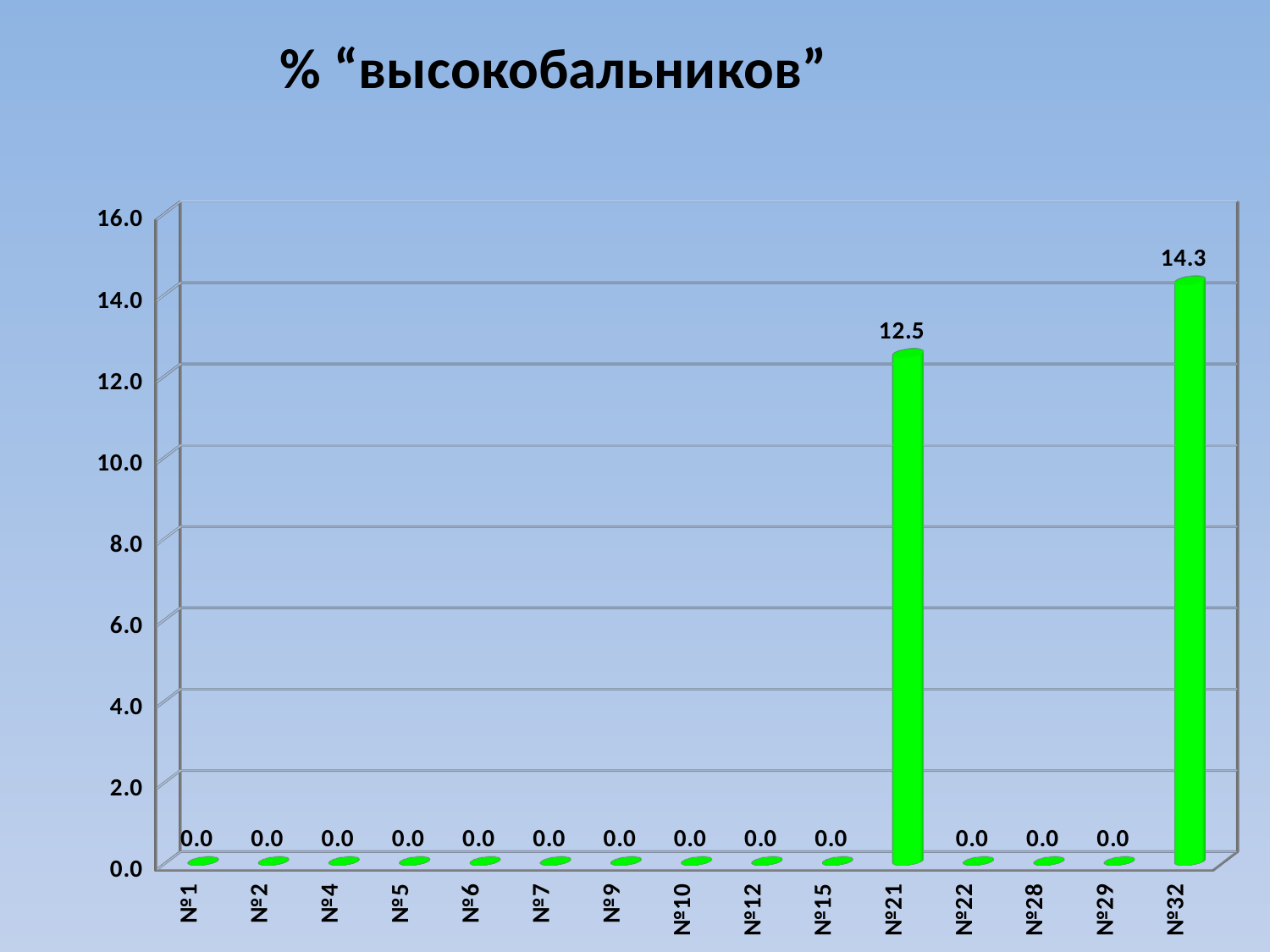
Is the value for №21 greater or less than 10.0? greater What kind of chart is shown on the slide? bar chart What is the value for №21? 12.5 What is the title of the chart? % “высокобальников” What is the difference between the values for №32 and №21? 1.8 What is the value for №32? 14.3 Which is larger, the value for №21 or the value for №32? №32 How many categories are shown on the x axis? 15 What is the value for №15? 0.0 Which category has the highest value? №32 How many categories have a value of 0.0? 13 Is the value for №32 greater or less than 16.0? less